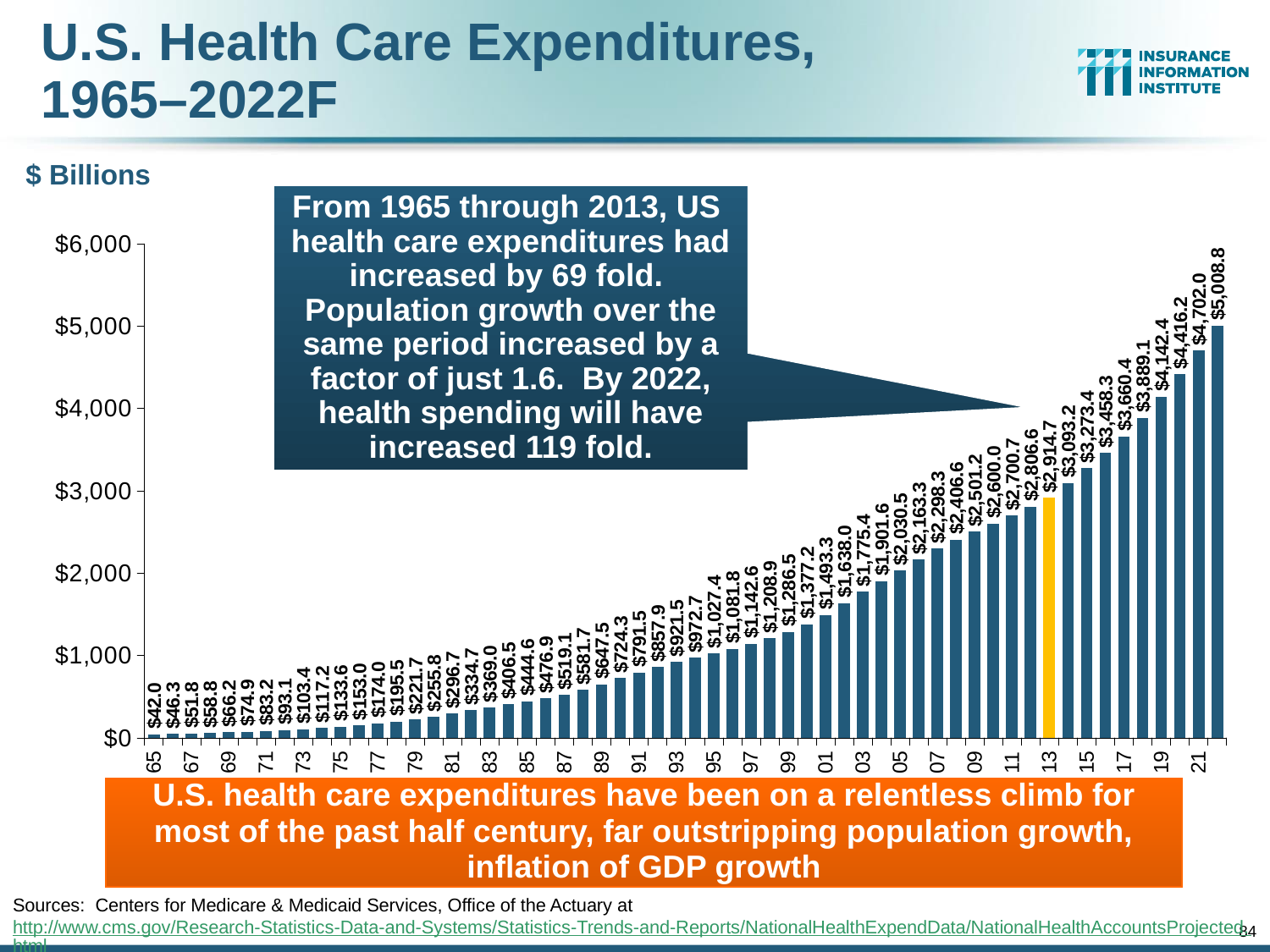
Which year has the highest value on the chart? 2022 (22) What was U.S. health care expenditure in 1985? $444.6 What was U.S. health care expenditure in 1965 according to the chart? $42.0 What type of chart is shown on the slide? Bar chart Which is larger, the value for 2013 or the value for 2001? 2013 How many bars (years) are plotted on the chart? 58 What is the value of the highlighted (yellow) bar for 2013? $2,914.7 Do the values generally rise or fall from 1965 to 2022? Rise What is the forecast value for 2022 on the chart? $5,008.8 What is the difference between the 2022 value and the 2013 value? $2,094.1 What was U.S. health care expenditure in 2001? $1,493.3 Which year has the lowest value on the chart? 1965 (65)